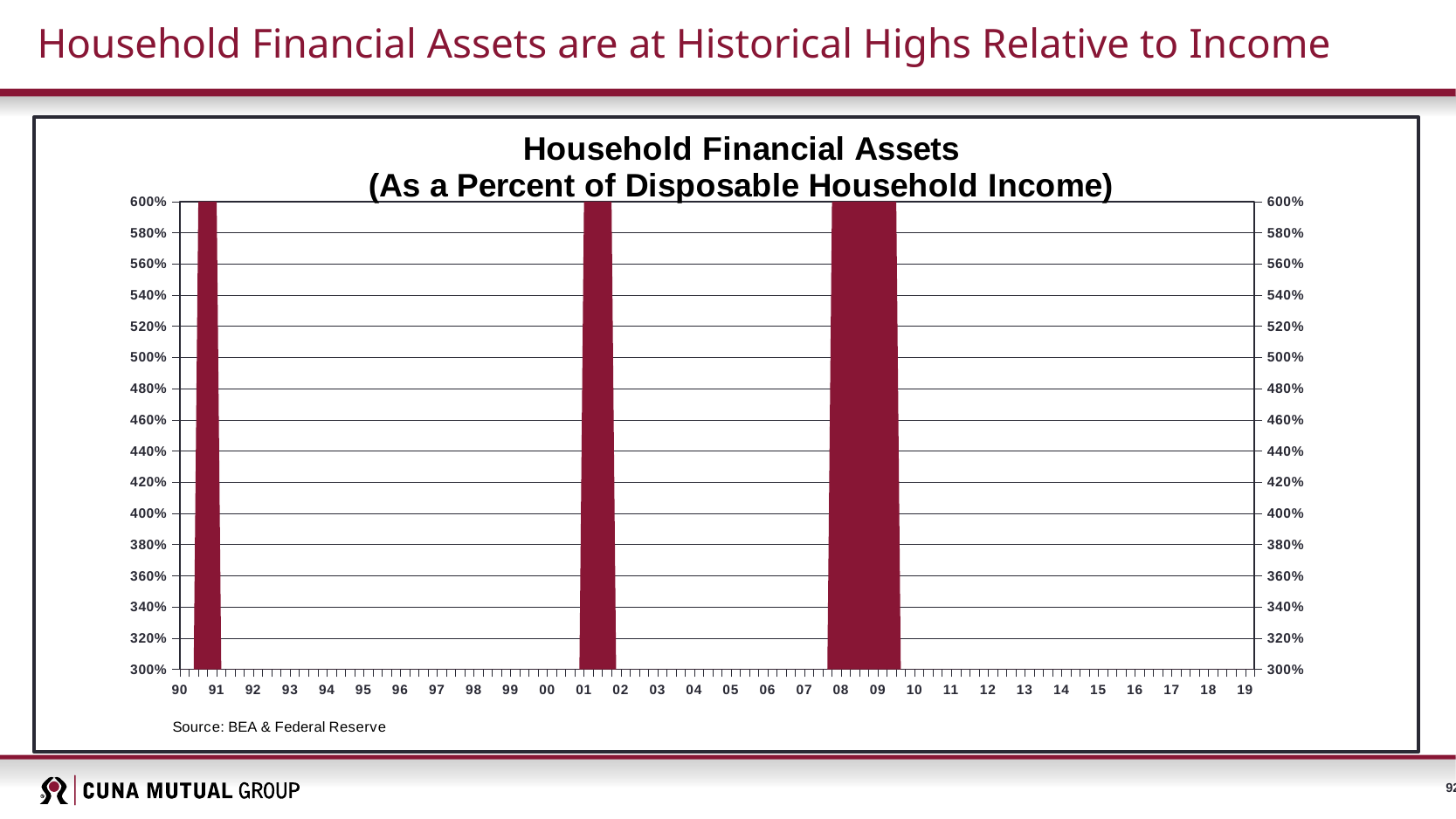
What is the title of the chart? Household Financial Assets (As a Percent of Disposable Household Income) Is the shaded bar at 01 greater or less than 500%? greater How many shaded bars are plotted on the chart? 3 What value does the shaded bar at 90 reach on the y axis? 600% What value does the shaded bar at 01 reach on the y axis? 600% Is the shaded bar at 08 greater or less than 400%? greater What is the highest value shown on the y axis of the chart? 600% What kind of chart is shown on the slide? bar chart